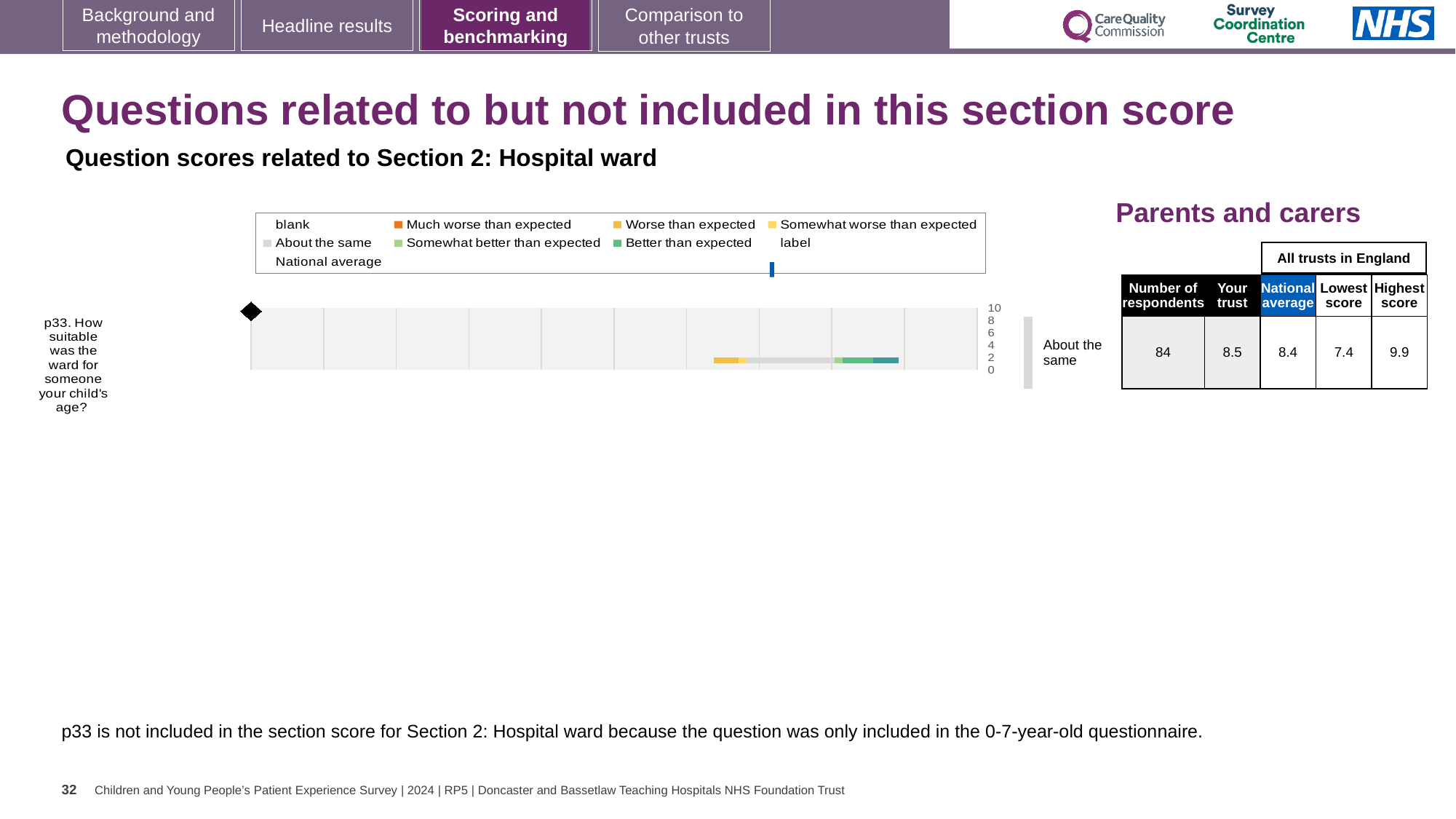
What kind of chart is used to show the p33 question score? bar chart What is the highest score among all trusts in England for p33? 9.9 What is the difference between the highest and lowest scores for p33? 2.5 How many questions are plotted in the chart? 1 What is the highest tick value shown on the chart's score axis? 10 Which is larger for p33, the 'Your trust' score or the national average? Your trust What is the 'Your trust' score for p33 in the Parents and carers table? 8.5 What is the lowest score among all trusts in England for p33? 7.4 What benchmark category is shown next to the chart for p33? About the same By how much does the 'Your trust' score for p33 exceed the national average? 0.1 How many respondents answered p33? 84 What is the national average score for p33? 8.4